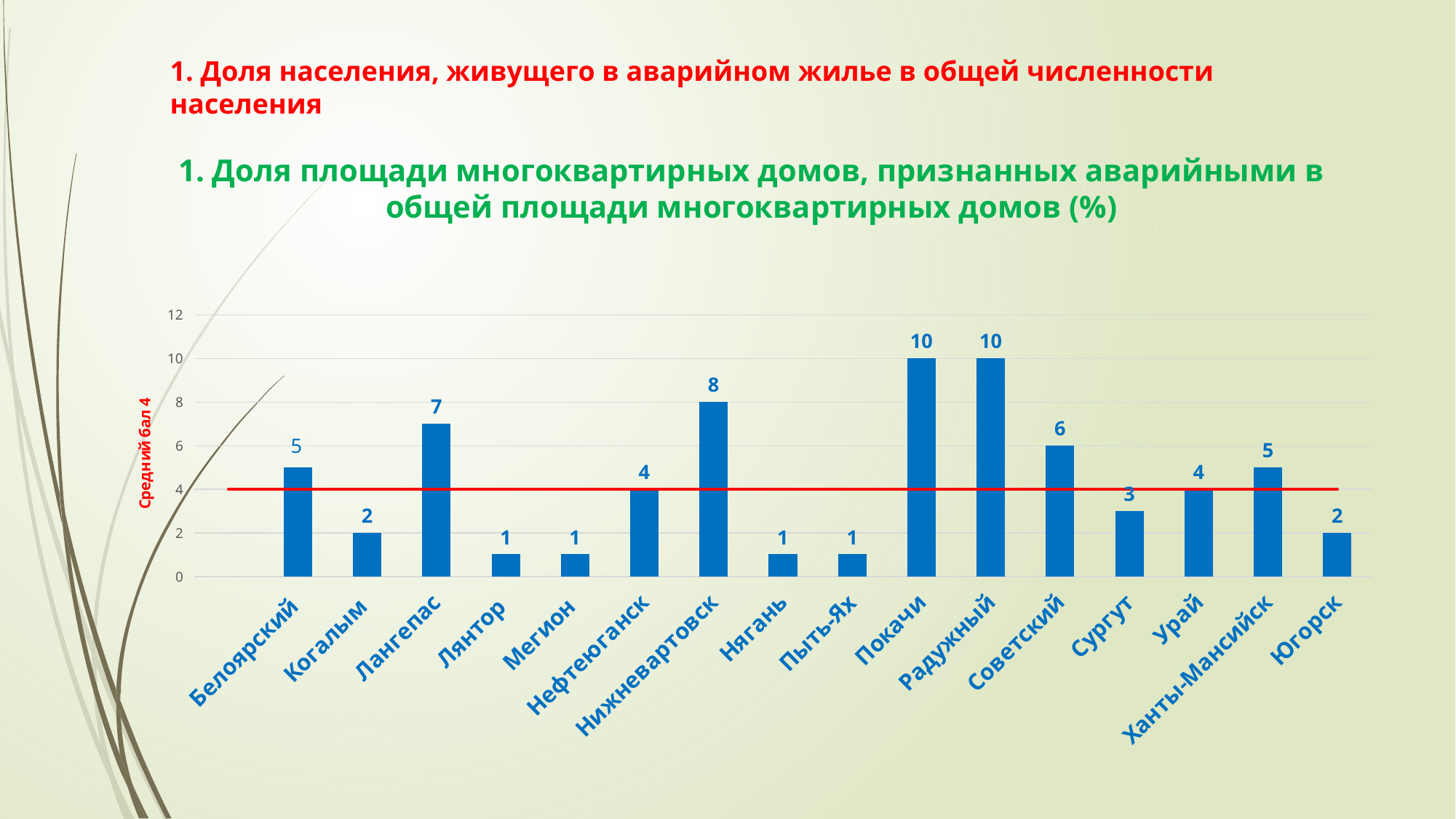
What is the difference between the values for Покачи and Белоярский? 5 Which has a larger value, Когалым or Ханты-Мансийск? Ханты-Мансийск What is the value for Лангепас? 7 What is the value for Нижневартовск? 8 Which two cities share the highest value on the chart? Покачи and Радужный What value does the red horizontal line on the chart mark, according to its label? Средний бал 4 What is the highest tick value shown on the vertical axis of the chart? 12 Which has a larger value, Лангепас or Советский? Лангепас What is the value for Советский? 6 What is the value for Сургут? 3 What kind of chart is shown on the slide? Bar chart How many cities are shown on the x axis of the chart? 16